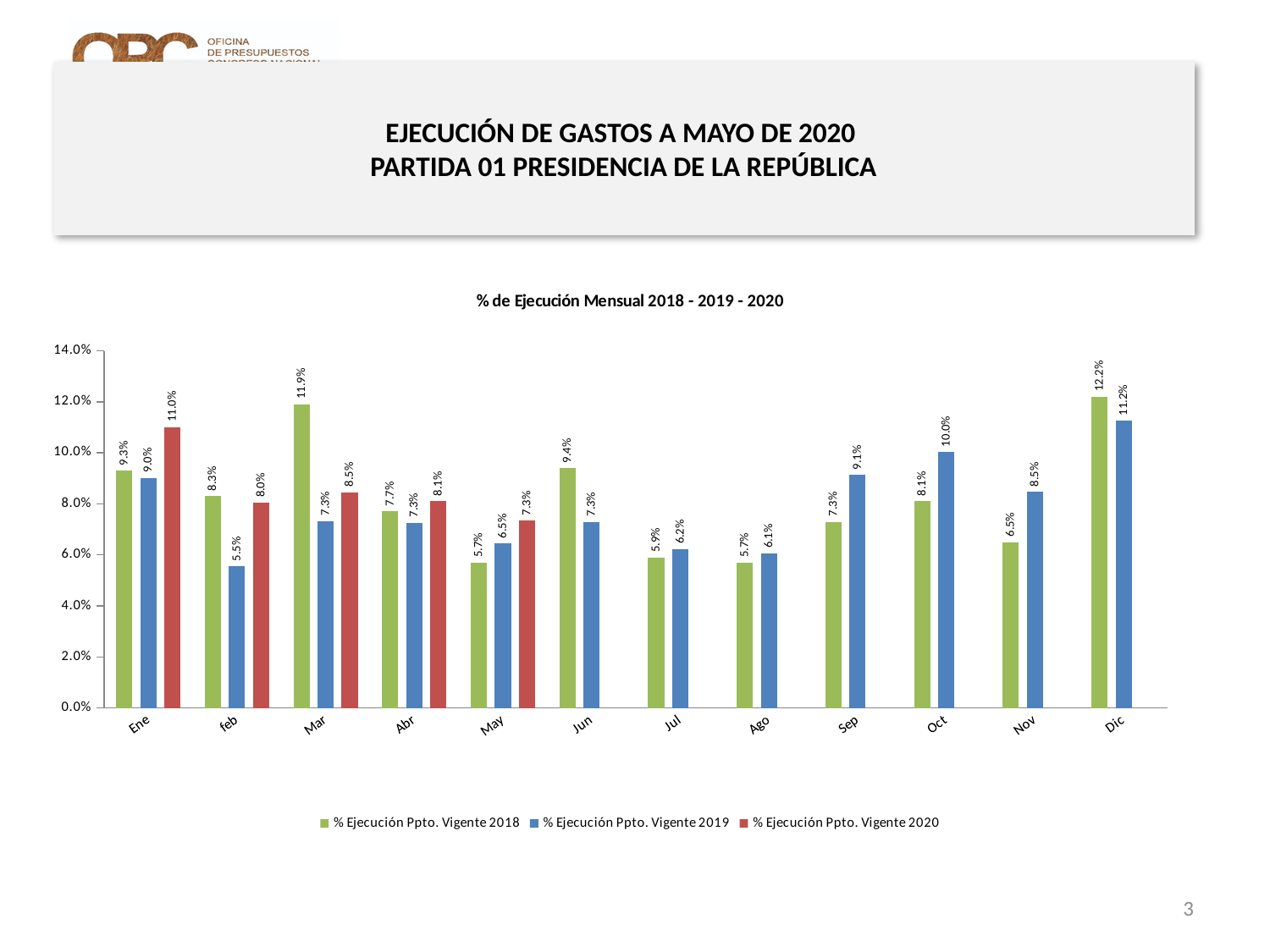
What is the difference between the 2018 and 2019 values for feb? 2.8% Which colour represents the % Ejecución Ppto. Vigente 2020 series? Red Is the value for Dic in the 2019 series greater or less than 10.0%? greater Which month has the lowest value in the % Ejecución Ppto. Vigente 2019 series? feb Which month has the highest value in the % Ejecución Ppto. Vigente 2018 series? Dic For Sep, which series has the larger value, 2018 or 2019? 2019 How many series does the legend list? 3 What is the value for Mar in the % Ejecución Ppto. Vigente 2018 series? 11.9% What kind of chart is shown on the slide? Bar chart What is the value for Oct in the % Ejecución Ppto. Vigente 2019 series? 10.0% How many months are shown on the x axis? 12 What is the value for Ene in the % Ejecución Ppto. Vigente 2020 series? 11.0%